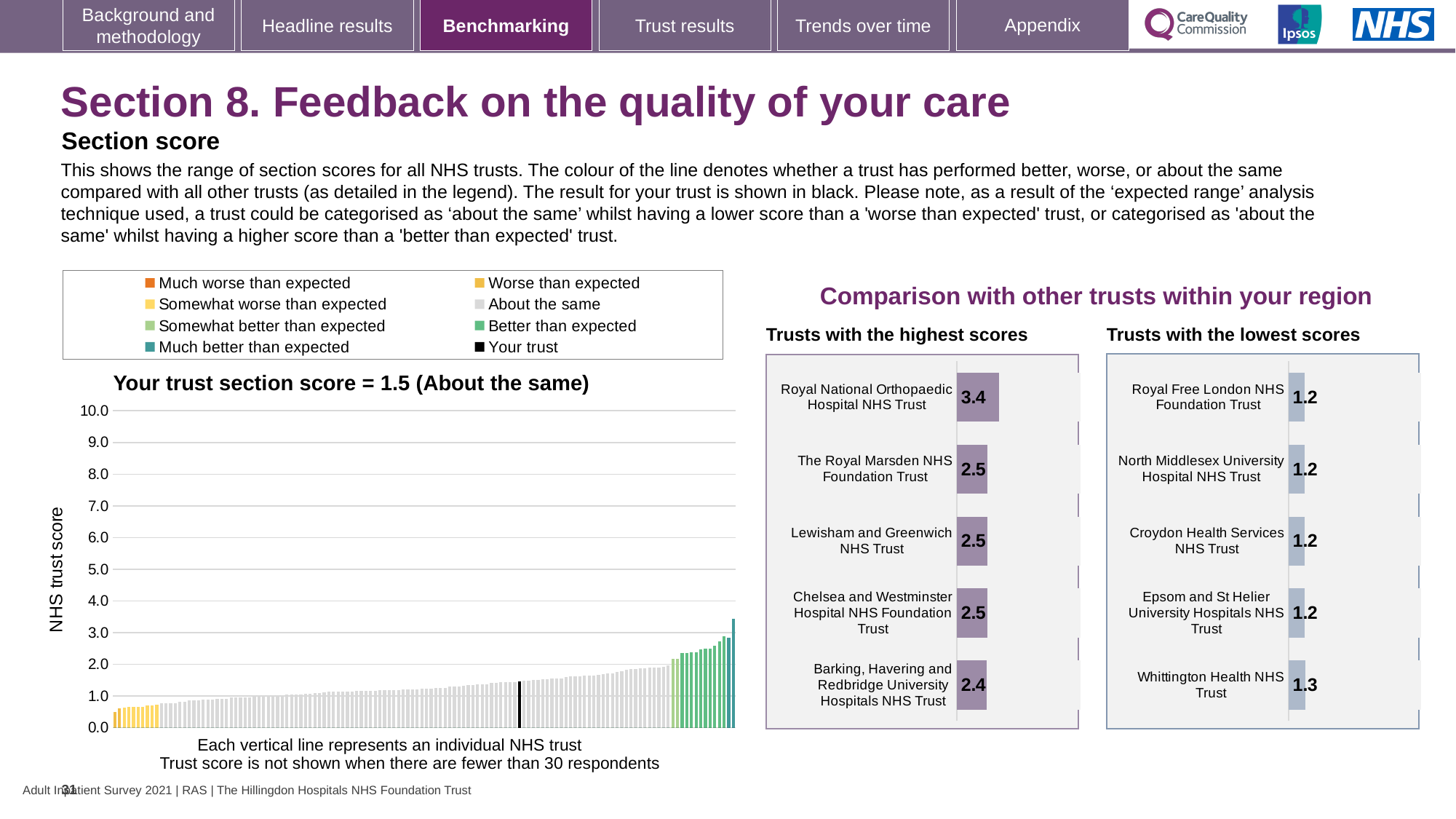
On the 'Your trust section score' chart, how many entries does the legend list? 8 On the 'Trusts with the highest scores' chart, how many trusts are listed? 5 On the 'Your trust section score' chart, what is the highest value shown on the vertical axis? 10.0 On the 'Trusts with the highest scores' chart, what is the difference between the scores of Royal National Orthopaedic Hospital NHS Trust and Barking, Havering and Redbridge University Hospitals NHS Trust? 1.0 On the 'Trusts with the lowest scores' chart, which trust has the highest score? Whittington Health NHS Trust On the 'Your trust section score' chart, what kind of chart is shown? bar chart On the 'Trusts with the lowest scores' chart, what is the score for Whittington Health NHS Trust? 1.3 On the 'Your trust section score' chart, what is the section score for your trust? 1.5 On the 'Trusts with the highest scores' chart, what is the score for Royal National Orthopaedic Hospital NHS Trust? 3.4 On the 'Your trust section score' chart, do the bars rise or fall from left to right? rise On the 'Your trust section score' chart, is the value of the tallest bar greater or less than 3.0? greater On the 'Trusts with the highest scores' chart, which trust has the highest score? Royal National Orthopaedic Hospital NHS Trust